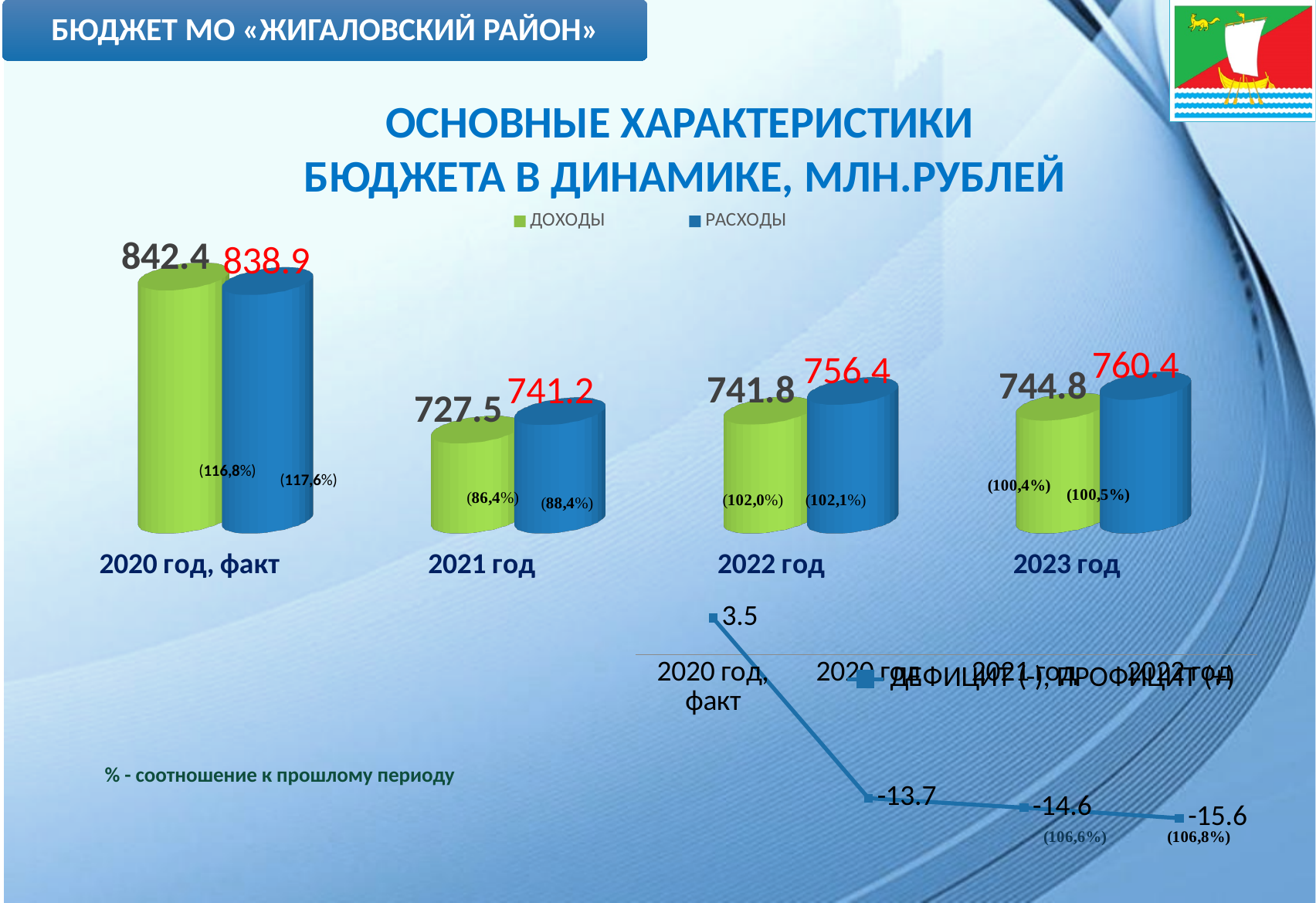
On the top bar chart, which year has the highest ДОХОДЫ value? 2020 год, факт On the top bar chart, what is the difference between РАСХОДЫ and ДОХОДЫ for 2022 год? 14.6 How many series does the legend of the top bar chart list? 2 On the bottom line chart, do the values rise or fall from left to right? fall What type of chart is the top chart showing ДОХОДЫ and РАСХОДЫ? bar chart On the top bar chart, what is the value of РАСХОДЫ for 2021 год? 741.2 How many year categories are shown on the top bar chart? 4 On the top bar chart, what is the value of РАСХОДЫ for 2023 год? 760.4 On the top bar chart, which year has the lowest ДОХОДЫ value? 2021 год On the bottom line chart, what is the first plotted value (for 2020 год, факт)? 3.5 On the top bar chart, what is the value of ДОХОДЫ for 2020 год, факт? 842.4 On the top bar chart, which is larger for 2020 год, факт: ДОХОДЫ or РАСХОДЫ? ДОХОДЫ